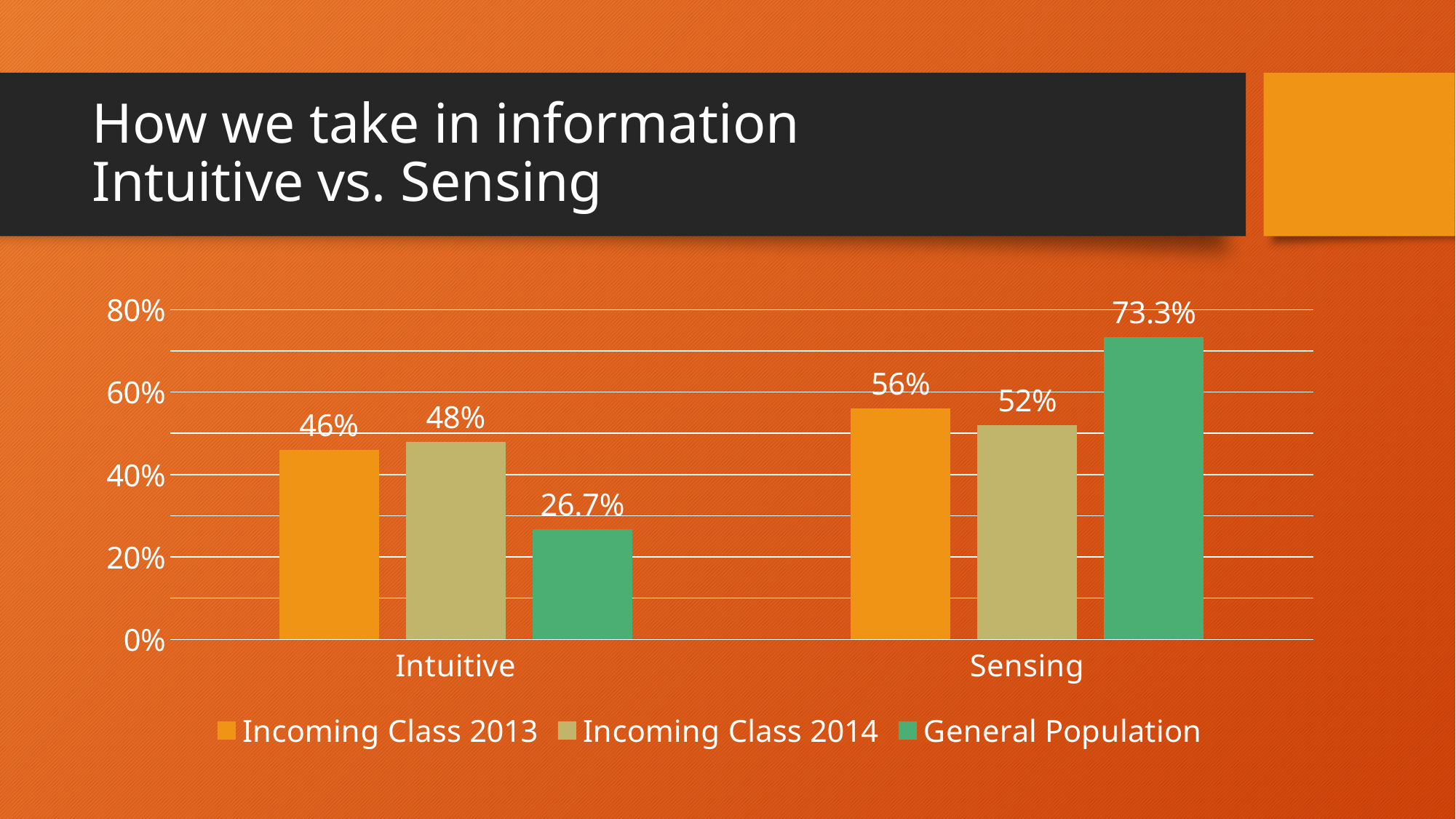
Which series has the lowest value in the Intuitive category? General Population What is the value for General Population in the Sensing category? 73.3% Which is larger: Incoming Class 2013 for Sensing or Incoming Class 2014 for Sensing? Incoming Class 2013 for Sensing How many series does the legend list? 3 What is the difference between the General Population values for Sensing and Intuitive? 46.6% What is the value for General Population in the Intuitive category? 26.7% What is the value for Incoming Class 2014 in the Sensing category? 52% What is the value for Incoming Class 2013 in the Intuitive category? 46% Which series has the highest value in the Sensing category? General Population What is the difference between the Incoming Class 2013 values for Sensing and Intuitive? 10% How many categories are shown on the x axis? 2 What kind of chart is shown on the slide? Bar chart